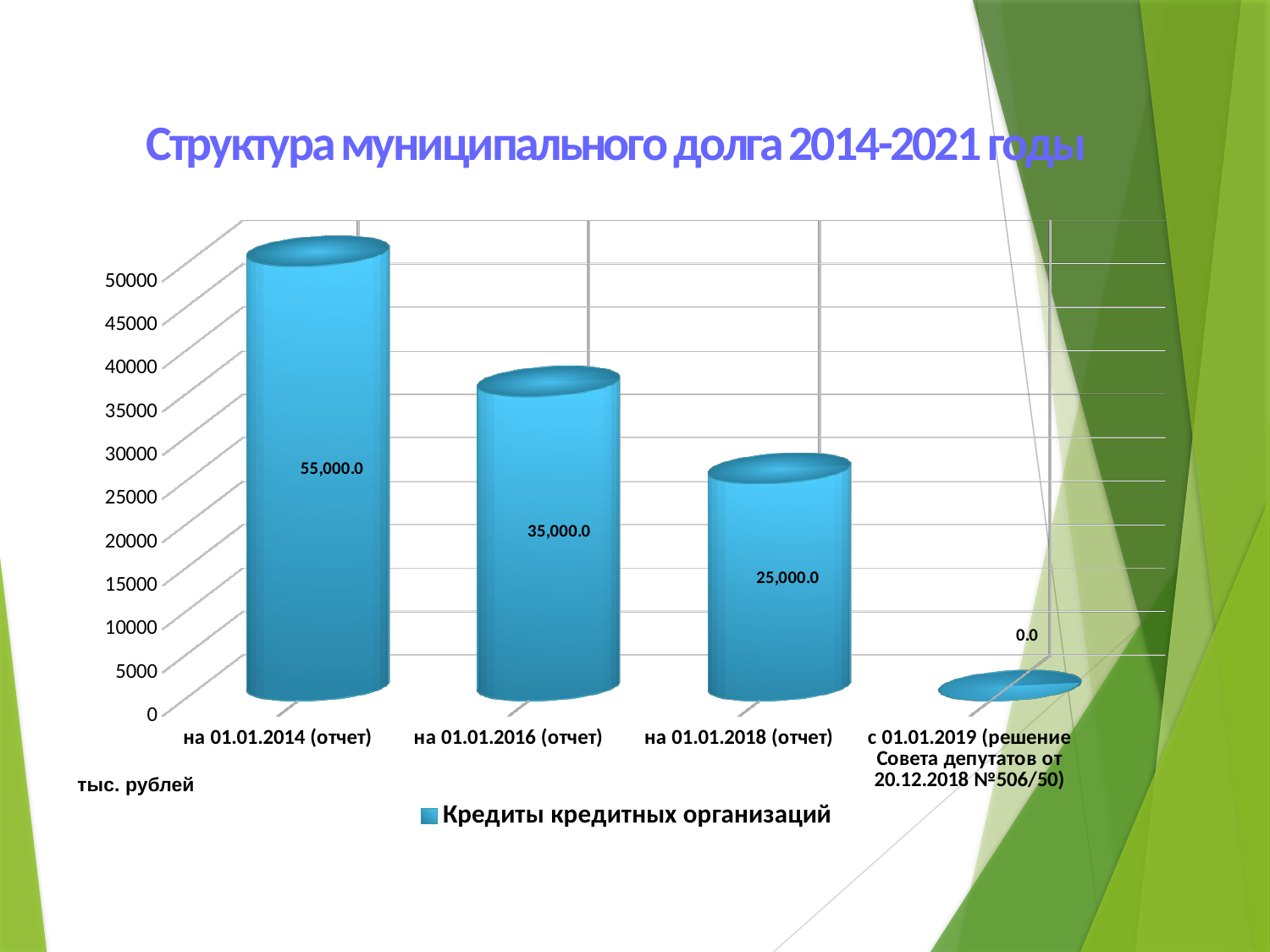
What kind of chart is shown on the slide? bar chart How many categories are shown on the x axis? 4 What is the value for "с 01.01.2019 (решение Совета депутатов от 20.12.2018 №506/50)"? 0.0 Which is larger, the value for "на 01.01.2016 (отчет)" or "на 01.01.2018 (отчет)"? на 01.01.2016 (отчет) How many series does the legend list? 1 Which category has the lowest value? с 01.01.2019 (решение Совета депутатов от 20.12.2018 №506/50) What is the value for "на 01.01.2014 (отчет)"? 55,000.0 What is the value for "на 01.01.2018 (отчет)"? 25,000.0 Which category has the highest value? на 01.01.2014 (отчет) What is the value for "на 01.01.2016 (отчет)"? 35,000.0 Do the values rise or fall along the x axis from left to right? fall What is the difference between the values for "на 01.01.2014 (отчет)" and "на 01.01.2016 (отчет)"? 20,000.0